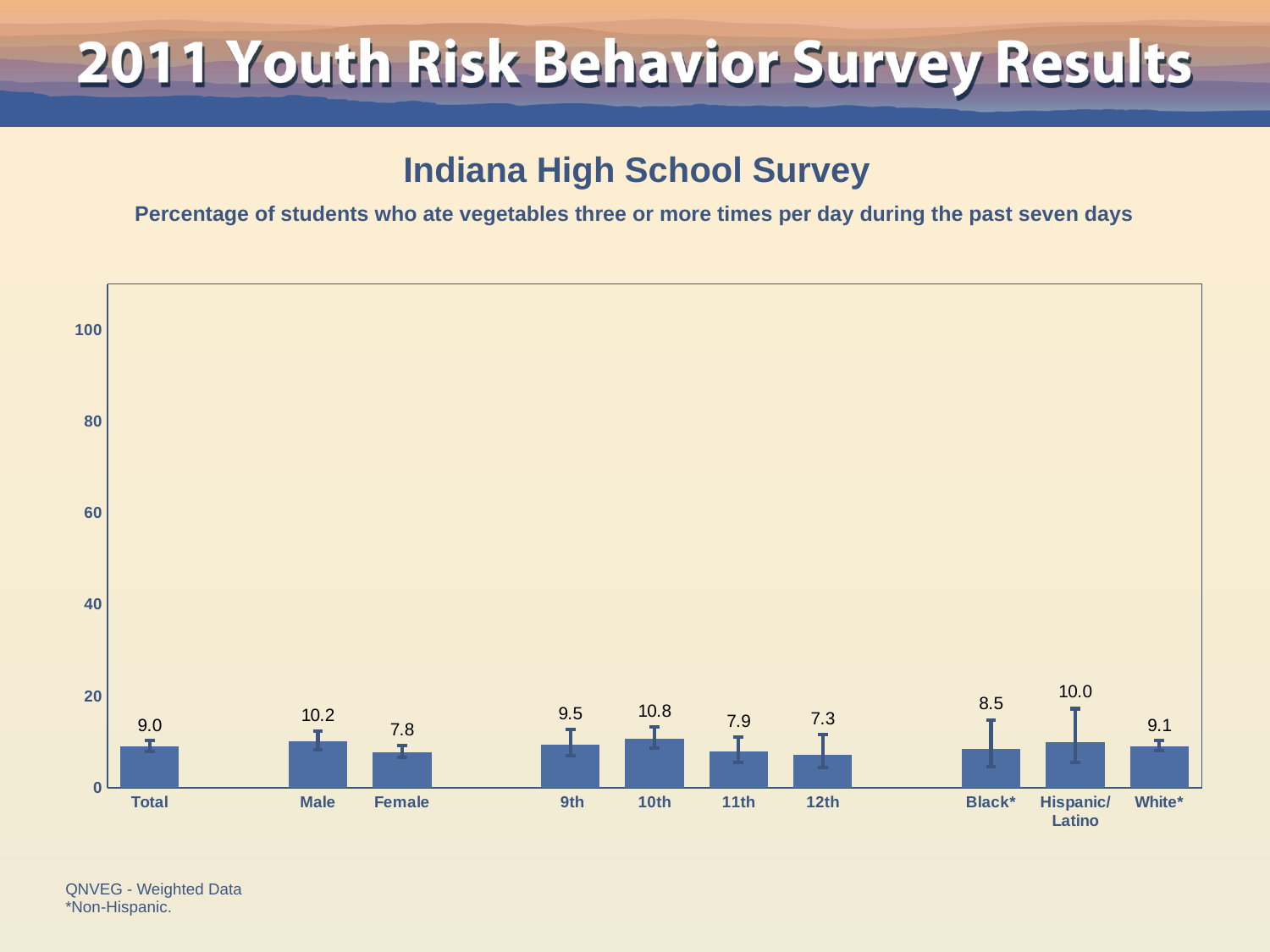
Is the value for Black* greater or less than 20? less Do the values rise or fall from 10th to 12th grade? fall Which is larger, the value for 9th or the value for 11th? 9th What kind of chart is shown on the slide? bar chart What is the value for Female? 7.8 How many categories are shown on the x axis? 10 What is the value for Total? 9.0 What is the subtitle describing what the chart measures? Percentage of students who ate vegetables three or more times per day during the past seven days What is the value for Hispanic/Latino? 10.0 Which category has the highest value? 10th What is the difference between the values for Male and Female? 2.4 Which category has the lowest value? 12th